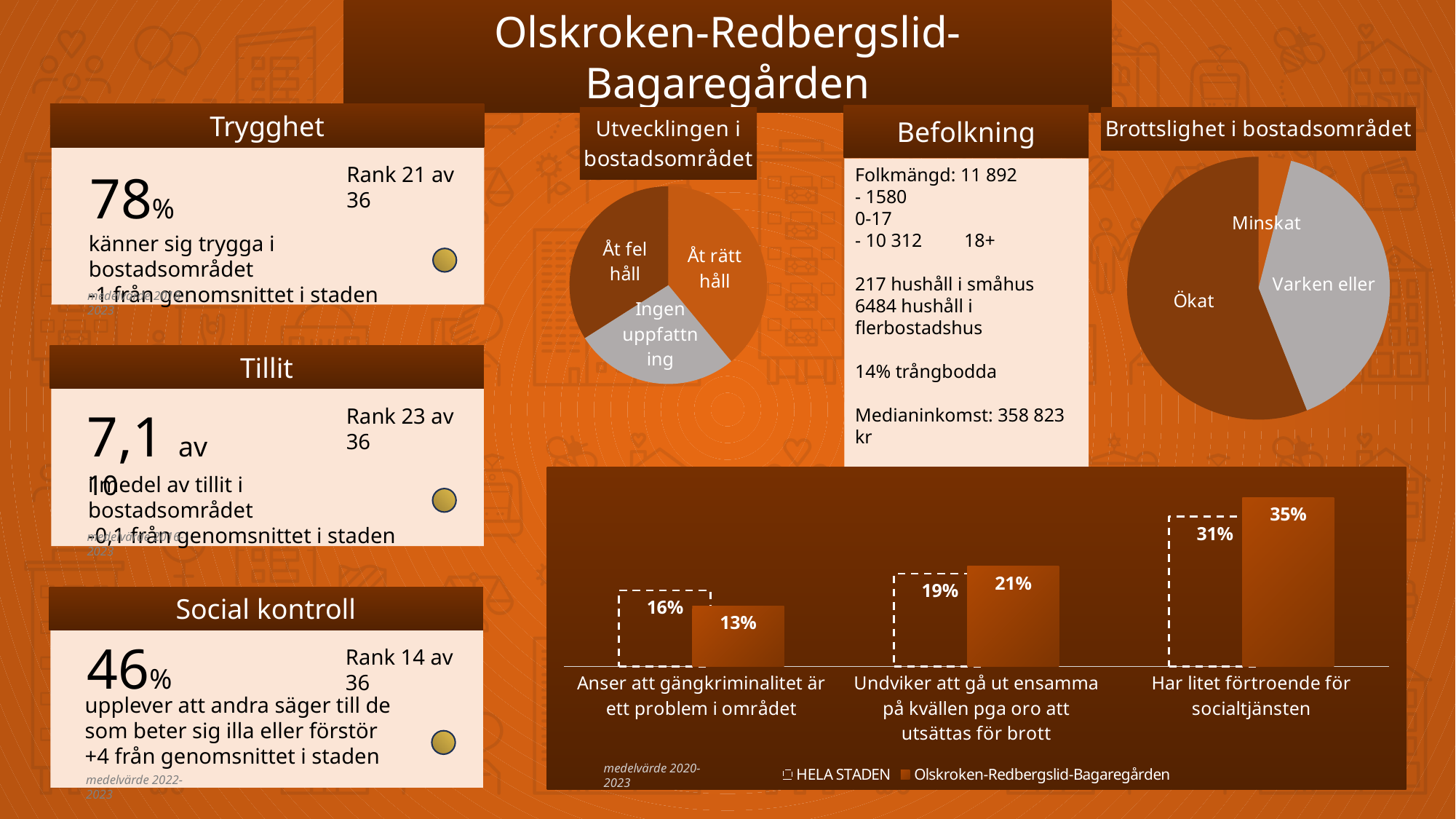
How many categories are shown in the bar chart at the bottom of the slide? 3 In the bar chart at the bottom of the slide, which is larger for 'Anser att gängkriminalitet är ett problem i området': HELA STADEN or Olskroken-Redbergslid-Bagaregården? HELA STADEN In the bar chart at the bottom of the slide, what is the value for HELA STADEN for 'Anser att gängkriminalitet är ett problem i området'? 16% In the bar chart at the bottom of the slide, which category has the highest value for Olskroken-Redbergslid-Bagaregården? Har litet förtroende för socialtjänsten In the bar chart at the bottom of the slide, what is the difference between Olskroken-Redbergslid-Bagaregården and HELA STADEN for 'Har litet förtroende för socialtjänsten'? 4 percentage points What kind of chart is 'Brottslighet i bostadsområdet'? Pie chart In the pie chart 'Brottslighet i bostadsområdet', which slice is the largest? Ökat How many series does the legend of the bar chart at the bottom of the slide list? 2 In the bar chart at the bottom of the slide, which category has the lowest value for HELA STADEN? Anser att gängkriminalitet är ett problem i området In the bar chart at the bottom of the slide, what is the value for Olskroken-Redbergslid-Bagaregården for 'Har litet förtroende för socialtjänsten'? 35% In the bar chart at the bottom of the slide, what is the value for Olskroken-Redbergslid-Bagaregården for 'Undviker att gå ut ensamma på kvällen pga oro att utsättas för brott'? 21% How many slices does the pie chart 'Utvecklingen i bostadsområdet' have? 3